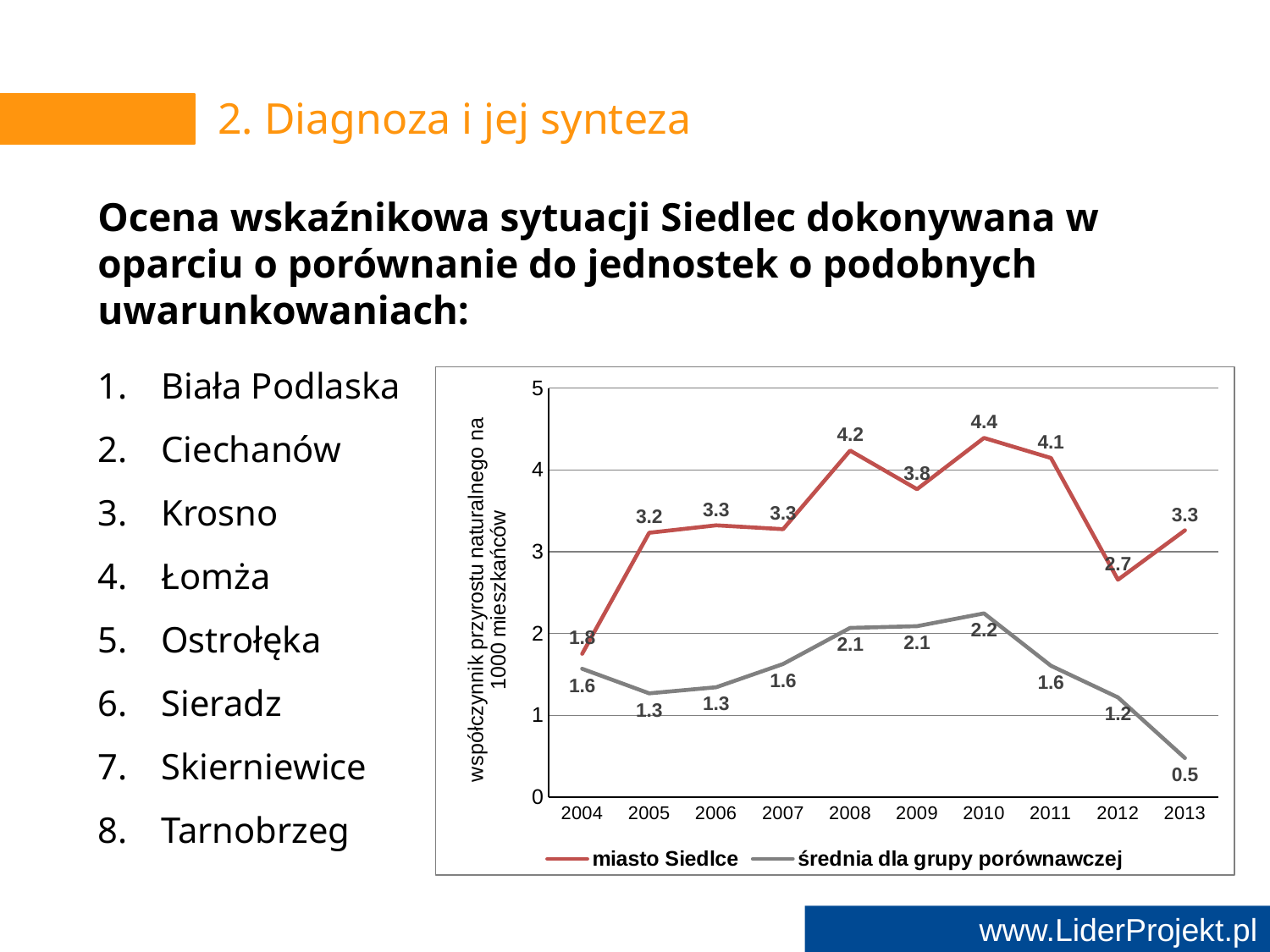
What colour is the line for miasto Siedlce? red Does the value for średnia dla grupy porównawczej rise or fall from 2011 to 2013? fall How many years are plotted on the x axis of the chart? 10 Which series has the larger value in 2012, miasto Siedlce or średnia dla grupy porównawczej? miasto Siedlce How many series does the chart legend list? 2 What is the difference between miasto Siedlce and średnia dla grupy porównawczej in 2008? 2.1 In which year does średnia dla grupy porównawczej reach its lowest value? 2013 What is the value for miasto Siedlce in 2010? 4.4 In which year does miasto Siedlce reach its highest value? 2010 What type of chart is shown on the slide? line chart What is the value for średnia dla grupy porównawczej in 2013? 0.5 Is the value for miasto Siedlce in 2004 greater or less than 2? less